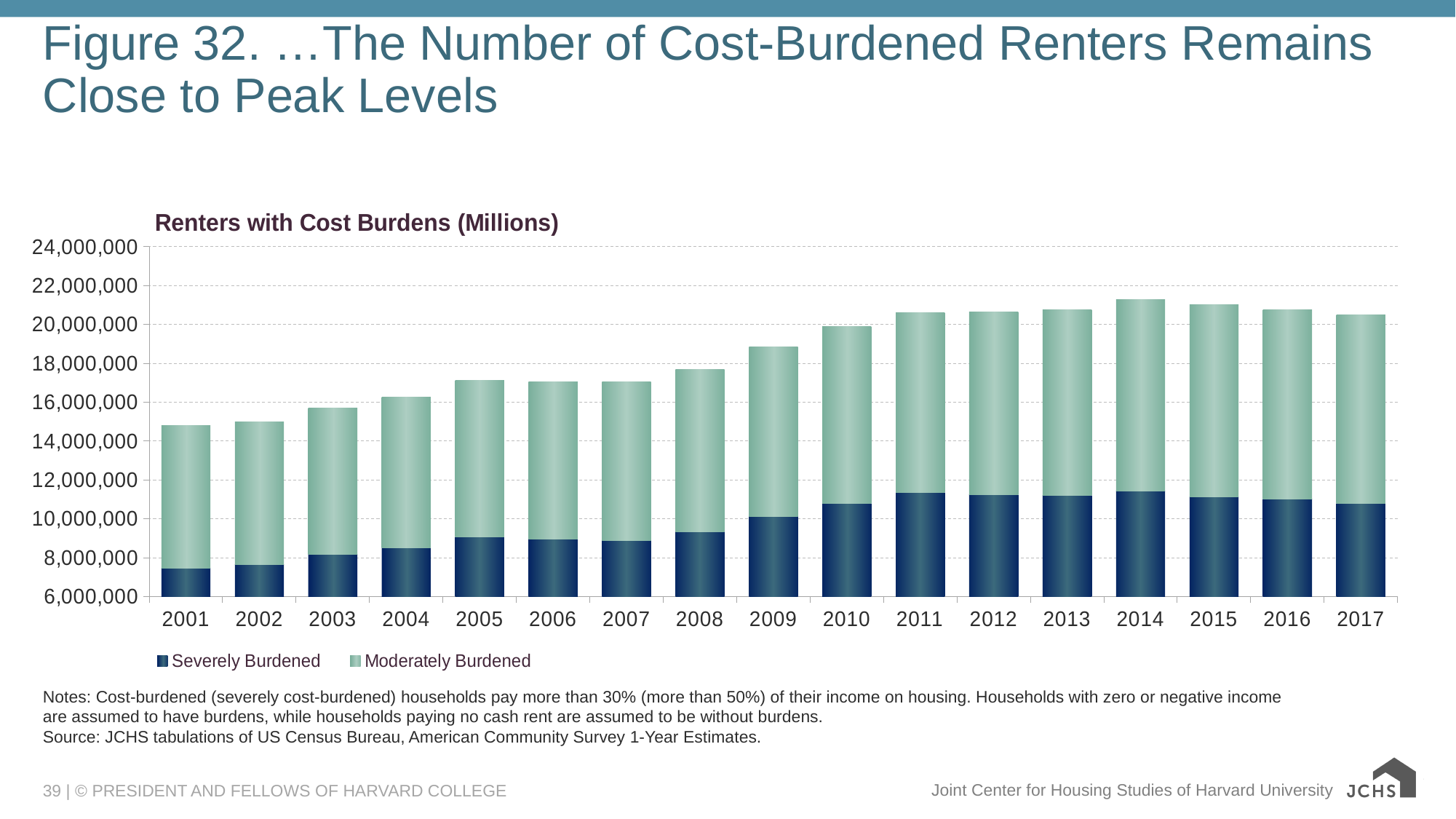
Is the number of severely burdened renters in 2014 greater or less than 10,000,000? greater Which year has a larger total number of cost-burdened renters, 2001 or 2017? 2017 How many series does the chart's legend list? 2 What is the title printed above the chart? Renters with Cost Burdens (Millions) What are the two series named in the legend? Severely Burdened and Moderately Burdened What kind of chart is shown on the slide? Stacked bar chart Is the total number of cost-burdened renters in 2014 greater or less than 20,000,000? greater How many years are shown on the x axis of the chart? 17 Is the total number of cost-burdened renters in 2001 greater or less than 16,000,000? less Which year has the highest total number of cost-burdened renters? 2014 Which year has the lowest total number of cost-burdened renters? 2001